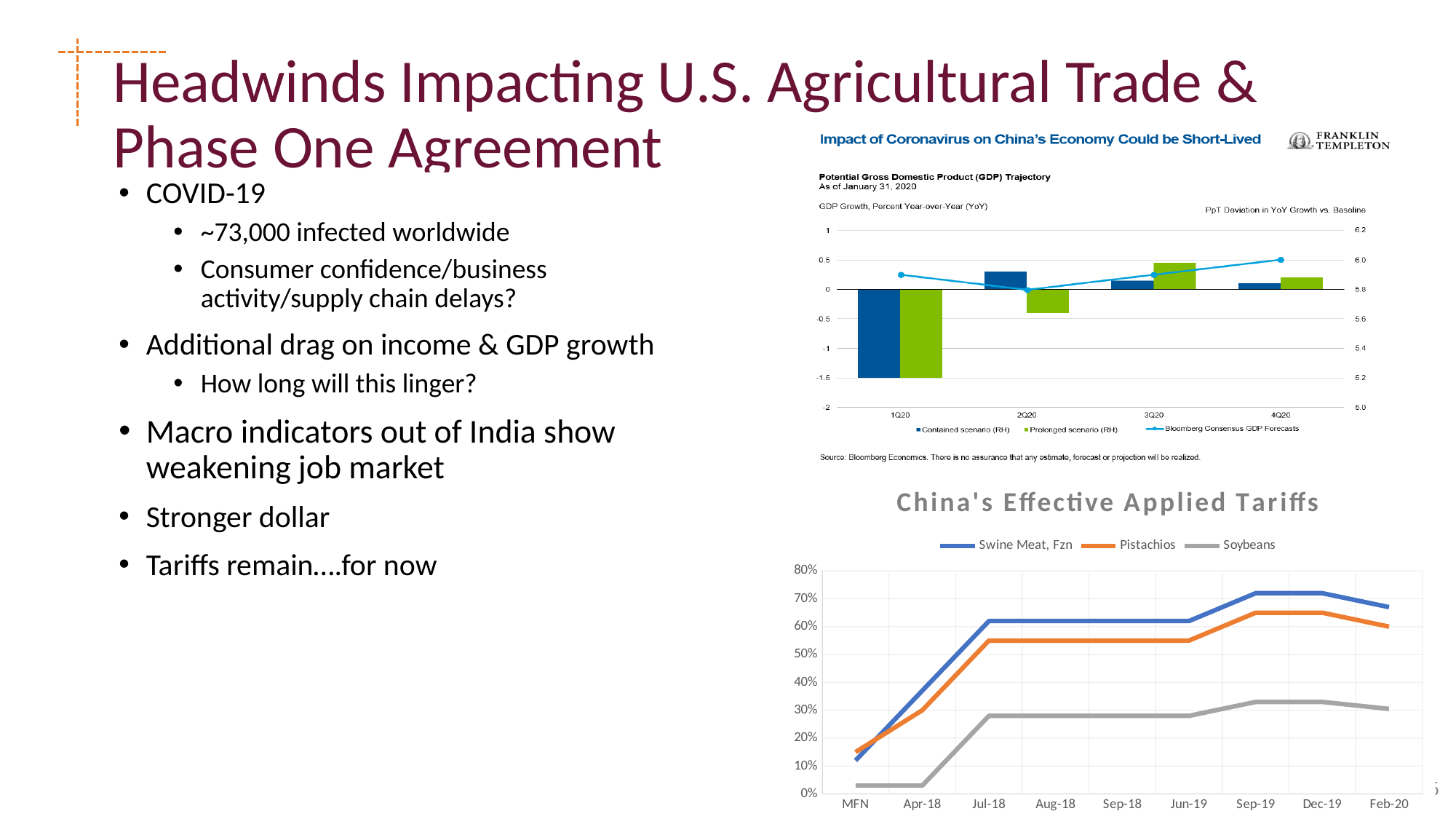
On the China's Effective Applied Tariffs chart, what kind of chart is it? line chart On the Potential Gross Domestic Product (GDP) Trajectory chart, which is larger at 3Q20, the Contained scenario (RH) bar or the Prolonged scenario (RH) bar? Prolonged scenario (RH) On the China's Effective Applied Tariffs chart, which series has the highest value at Feb-20? Swine Meat, Fzn On the Potential Gross Domestic Product (GDP) Trajectory chart, is the Prolonged scenario (RH) value for 2Q20 greater or less than 0? less On the Potential Gross Domestic Product (GDP) Trajectory chart, how many series does the legend list? 3 On the China's Effective Applied Tariffs chart, is the value for Soybeans at MFN greater or less than 10%? less On the China's Effective Applied Tariffs chart, how many points are on the x axis? 9 On the China's Effective Applied Tariffs chart, does the Soybeans series rise or fall from MFN to Sep-19? rise On the China's Effective Applied Tariffs chart, is the value for Pistachios at Sep-19 greater or less than 60%? greater On the China's Effective Applied Tariffs chart, which series has the lowest value at Sep-19? Soybeans On the China's Effective Applied Tariffs chart, how many series does the legend list? 3